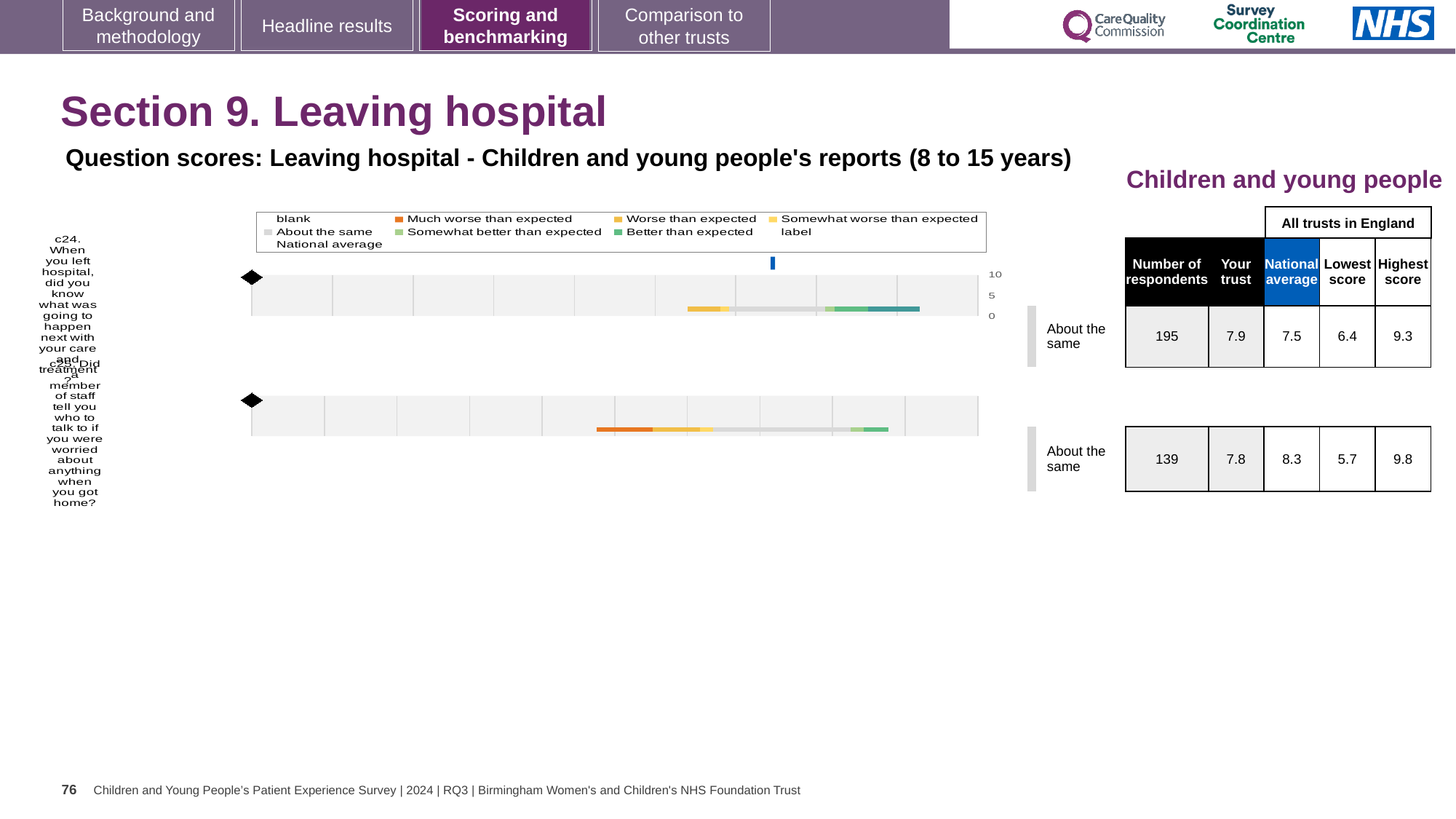
What kind of chart is used to show the benchmarking for questions c24 and c25? bar chart Is the trust's score for question c25 greater or less than 5 on the chart axis? greater What benchmark category is shown for question c24? About the same How many questions (bars) are plotted on the slide? 2 For question c24, which is larger: the trust's score or the national average? Your trust What is the difference between the trust's score and the national average for question c24? 0.4 What is the highest score across all trusts in England for question c25? 9.8 What is the 'Your trust' score for question c24 (When you left hospital, did you know what was going to happen next with your care and treatment?)? 7.9 What is the national average score for question c25 (Did a member of staff tell you who to talk to if you were worried about anything when you got home?)? 8.3 What is the difference between the highest and lowest scores across all trusts in England for question c25? 4.1 How many respondents answered question c24? 195 Which question has the lower 'Lowest score' across all trusts in England, c24 or c25? c25